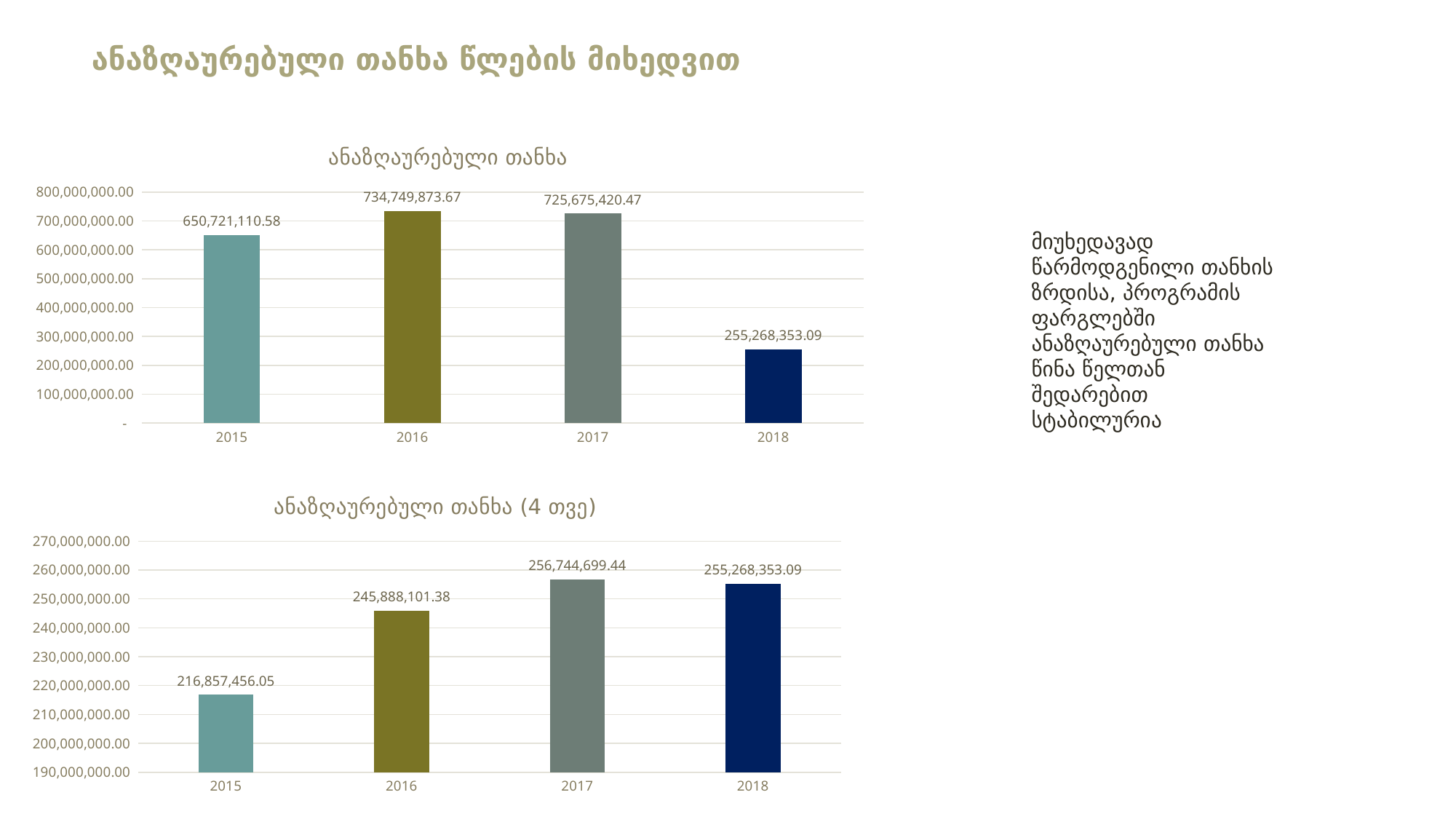
In the bottom chart (ანაზღაურებული თანხა (4 თვე)), is the value for 2017 or 2018 larger? 2017 In the top chart (ანაზღაურებული თანხა), how many years are shown? 4 In the top chart (ანაზღაურებული თანხა), what is the value for 2015? 650,721,110.58 In the top chart (ანაზღაურებული თანხა), which year has the lowest value? 2018 In the bottom chart (ანაზღაურებული თანხა (4 თვე)), what is the difference between the 2016 and 2015 values? 29,030,645.33 In the bottom chart (ანაზღაურებული თანხა (4 თვე)), which year has the lowest value? 2015 In the bottom chart (ანაზღაურებული თანხა (4 თვე)), what is the value for 2016? 245,888,101.38 In the top chart (ანაზღაურებული თანხა), which year has the highest value? 2016 What type of chart is the bottom chart (ანაზღაურებული თანხა (4 თვე))? Bar chart In the bottom chart (ანაზღაურებული თანხა (4 თვე)), which year has the highest value? 2017 In the top chart (ანაზღაურებული თანხა), what is the value for 2018? 255,268,353.09 In the top chart (ანაზღაურებული თანხა), what is the difference between the 2016 and 2017 values? 9,074,453.20